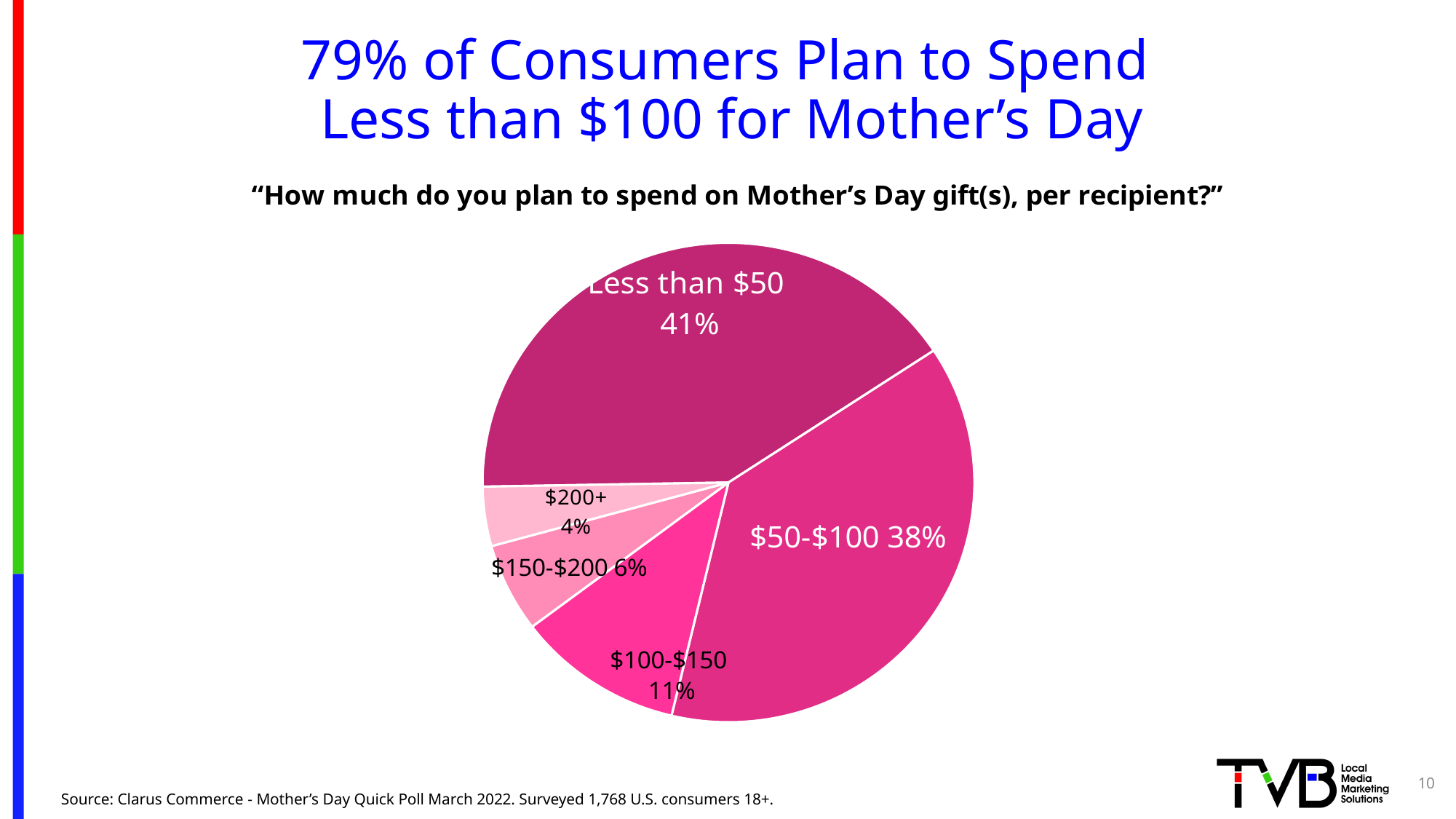
What share of consumers plan to spend $50-$100 per recipient? 38% What share of consumers plan to spend $150-$200 per recipient? 6% What share of consumers plan to spend less than $50 per recipient? 41% Which spending range has the smallest share of the pie? $200+ What is the combined share of the Less than $50 and $50-$100 slices? 79% What share of consumers plan to spend $200+ per recipient? 4% How many spending categories are shown in the pie chart? 5 What is the difference in percentage points between the Less than $50 slice and the $50-$100 slice? 3 percentage points What share of consumers plan to spend $100-$150 per recipient? 11% Which is larger: the share for $100-$150 or the share for $150-$200? $100-$150 Which spending range has the largest share of the pie? Less than $50 What kind of chart is shown on the slide? pie chart